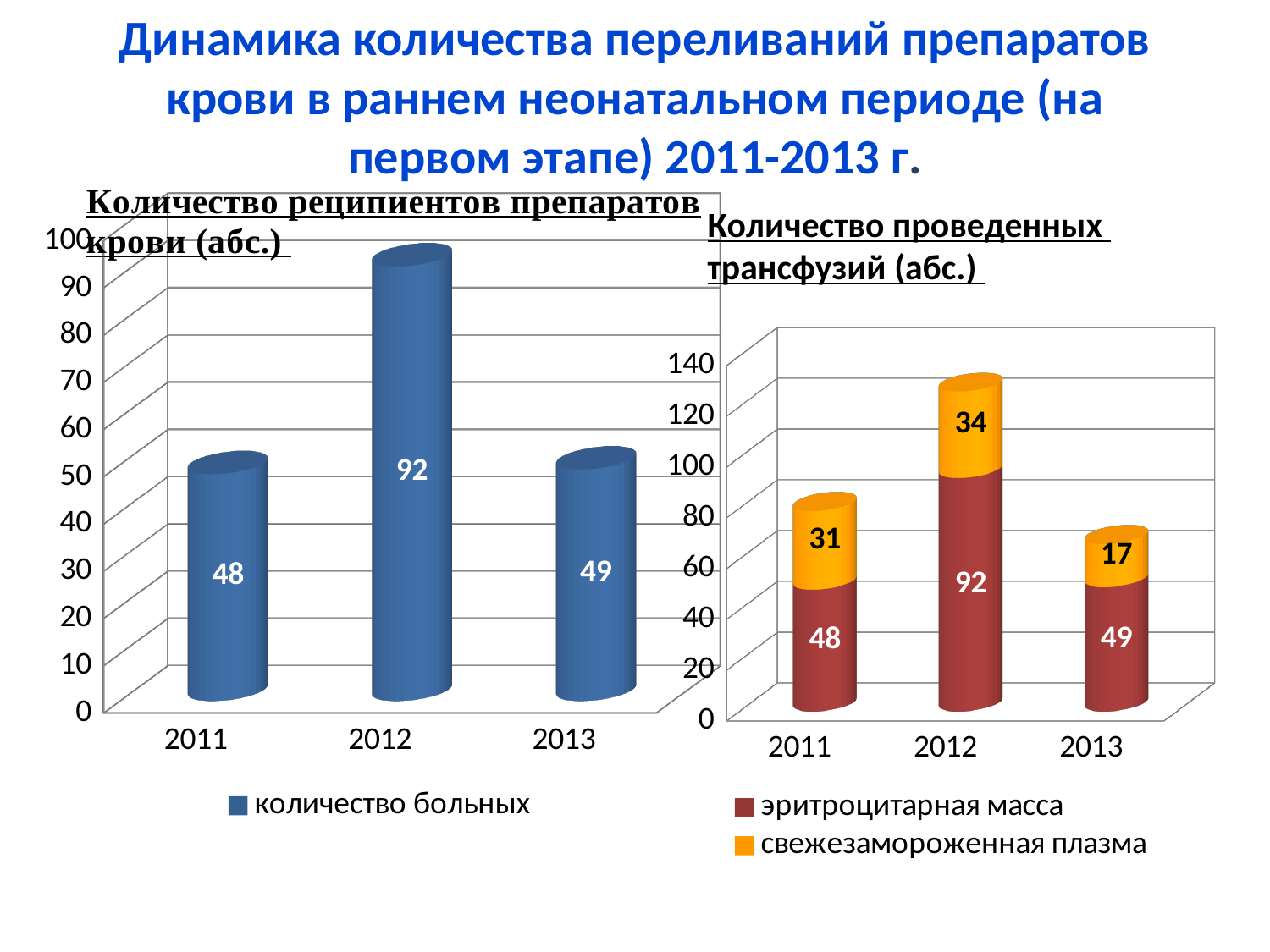
In the right chart (Количество проведенных трансфузий), what is the total of the stacked bar for 2012? 126 In the right chart (Количество проведенных трансфузий), which year has the highest value of свежезамороженная плазма? 2012 In the right chart (Количество проведенных трансфузий), how many series does the legend list? 2 What kind of chart is the left chart (Количество реципиентов препаратов крови)? bar chart In the right chart (Количество проведенных трансфузий), is the value of свежезамороженная плазма for 2011 larger or smaller than for 2013? larger In the right chart (Количество проведенных трансфузий), which colour represents эритроцитарная масса? dark red In the left chart (Количество реципиентов препаратов крови), which year has the lowest value? 2011 In the right chart (Количество проведенных трансфузий), what is the value of свежезамороженная плазма for 2011? 31 In the left chart (Количество реципиентов препаратов крови), what is the difference between the values for 2012 and 2011? 44 In the left chart (Количество реципиентов препаратов крови), how many years are shown on the x axis? 3 In the right chart (Количество проведенных трансфузий), what is the value of эритроцитарная масса for 2013? 49 In the left chart (Количество реципиентов препаратов крови), what is the value for 2012? 92